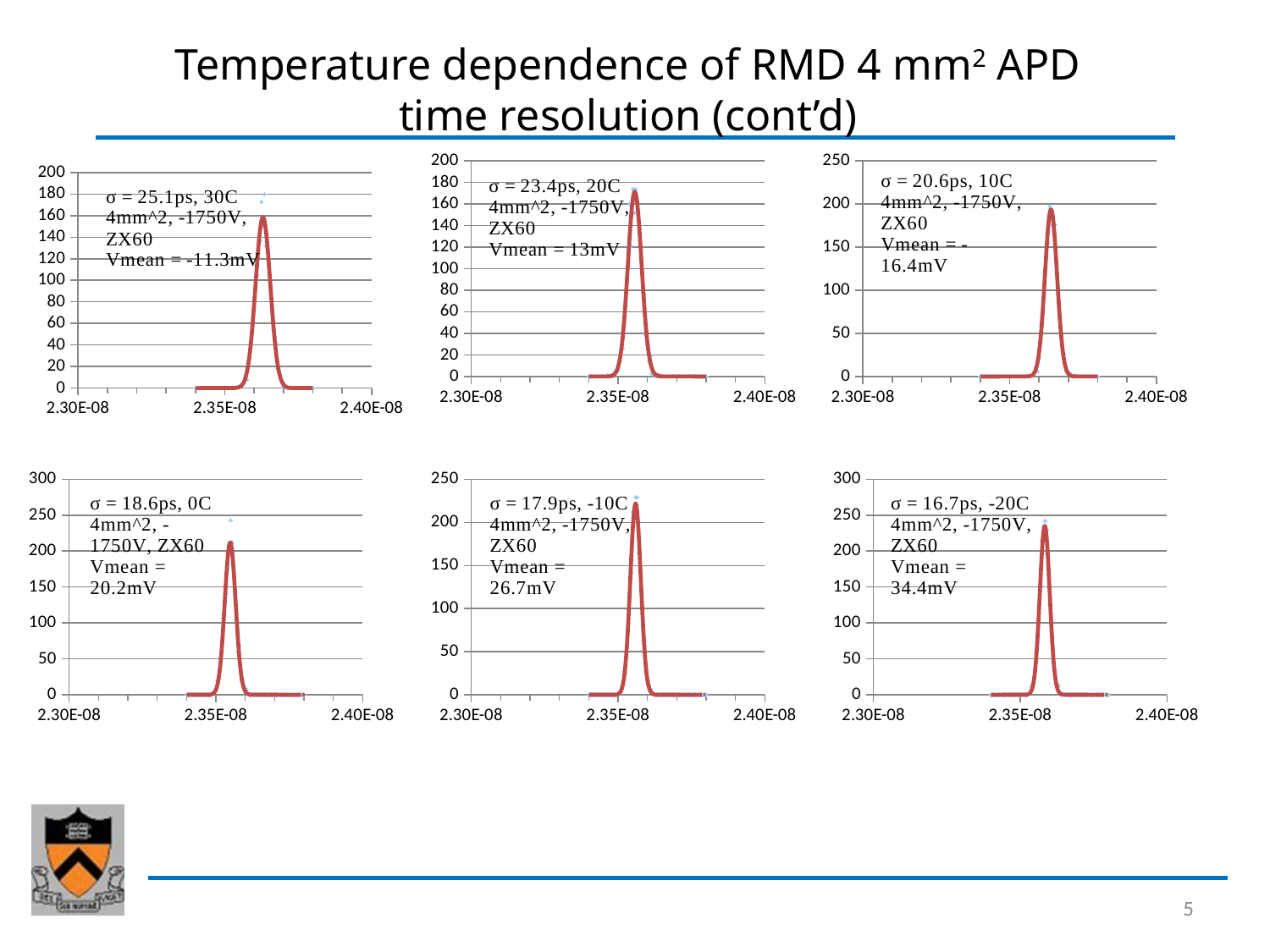
What kind of chart is the top-left chart (σ = 25.1ps, 30C)? line chart In the bottom-right chart (-20C), is the peak value of the curve greater or less than 200? greater In the bottom-left chart (0C), what is Vmean according to the annotation? 20.2mV In the top-right chart (10C), what is the value of σ given in the annotation? 20.6ps What is the maximum value shown on the y axis of the bottom-left chart (0C)? 300 How many charts are shown on the slide? 6 In the top-left chart (30C), is the peak value of the curve greater or less than 100? greater In the top-left chart, what is the value of σ given in the annotation? 25.1ps In the top-right chart (10C), is the peak value of the curve greater or less than 150? greater In the top-middle chart (20C), what is Vmean according to the annotation? 13mV In the bottom-right chart (-20C), what is the value of σ given in the annotation? 16.7ps In the bottom-middle chart (-10C), what is Vmean according to the annotation? 26.7mV